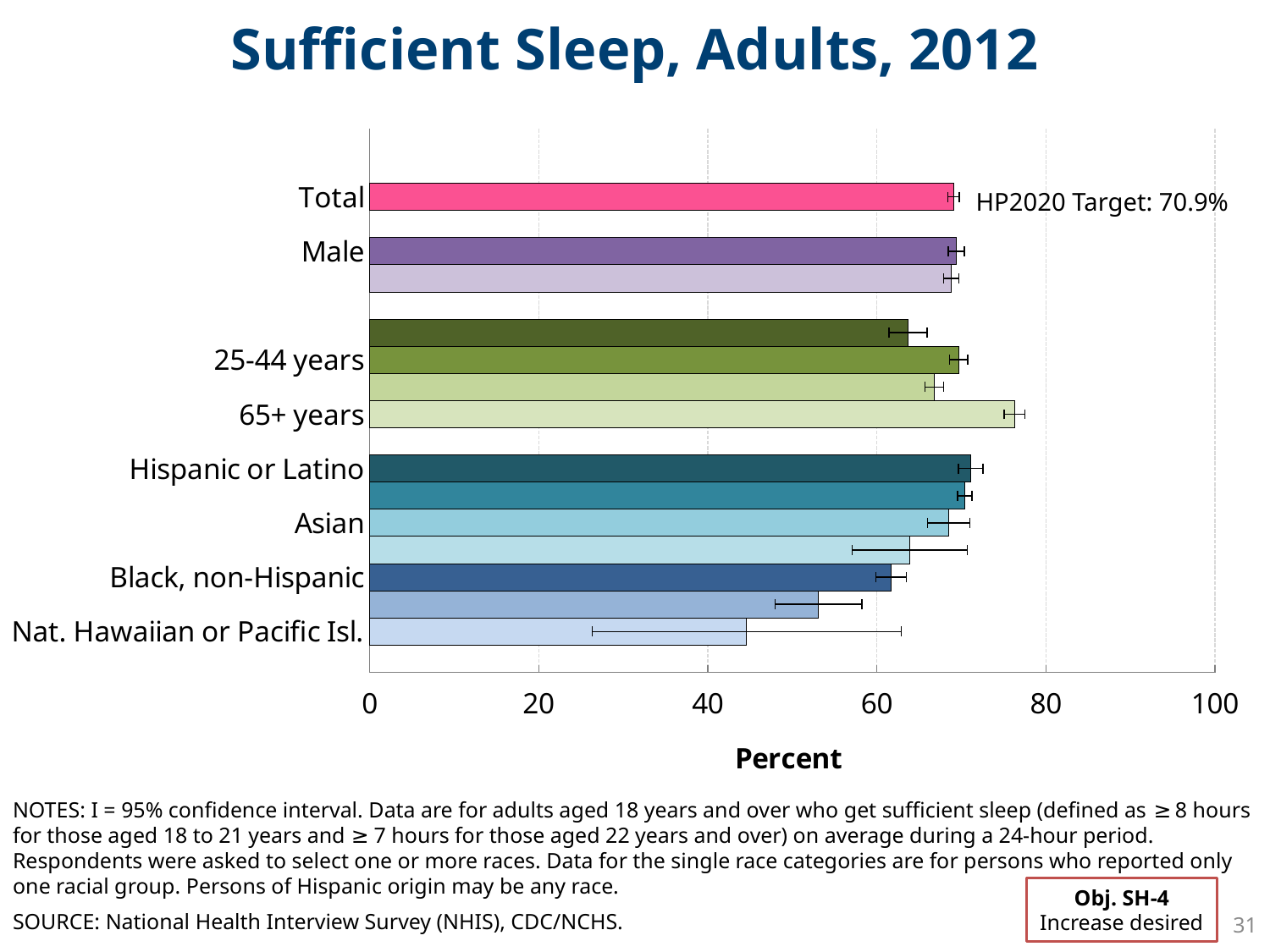
Which labeled category has the lowest value? Nat. Hawaiian or Pacific Isl. Is the value for Total greater or less than 60? greater Is the value for 65+ years greater or less than 60? greater Is the value for Hispanic or Latino greater or less than 60? greater What is the title of the chart? Sufficient Sleep, Adults, 2012 What kind of chart is shown on the slide? bar chart Which labeled category has the highest value? 65+ years Which is larger, the value for 65+ years or the value for Black, non-Hispanic? 65+ years How many bars are plotted on the chart? 14 What HP2020 Target value is printed on the chart? 70.9%